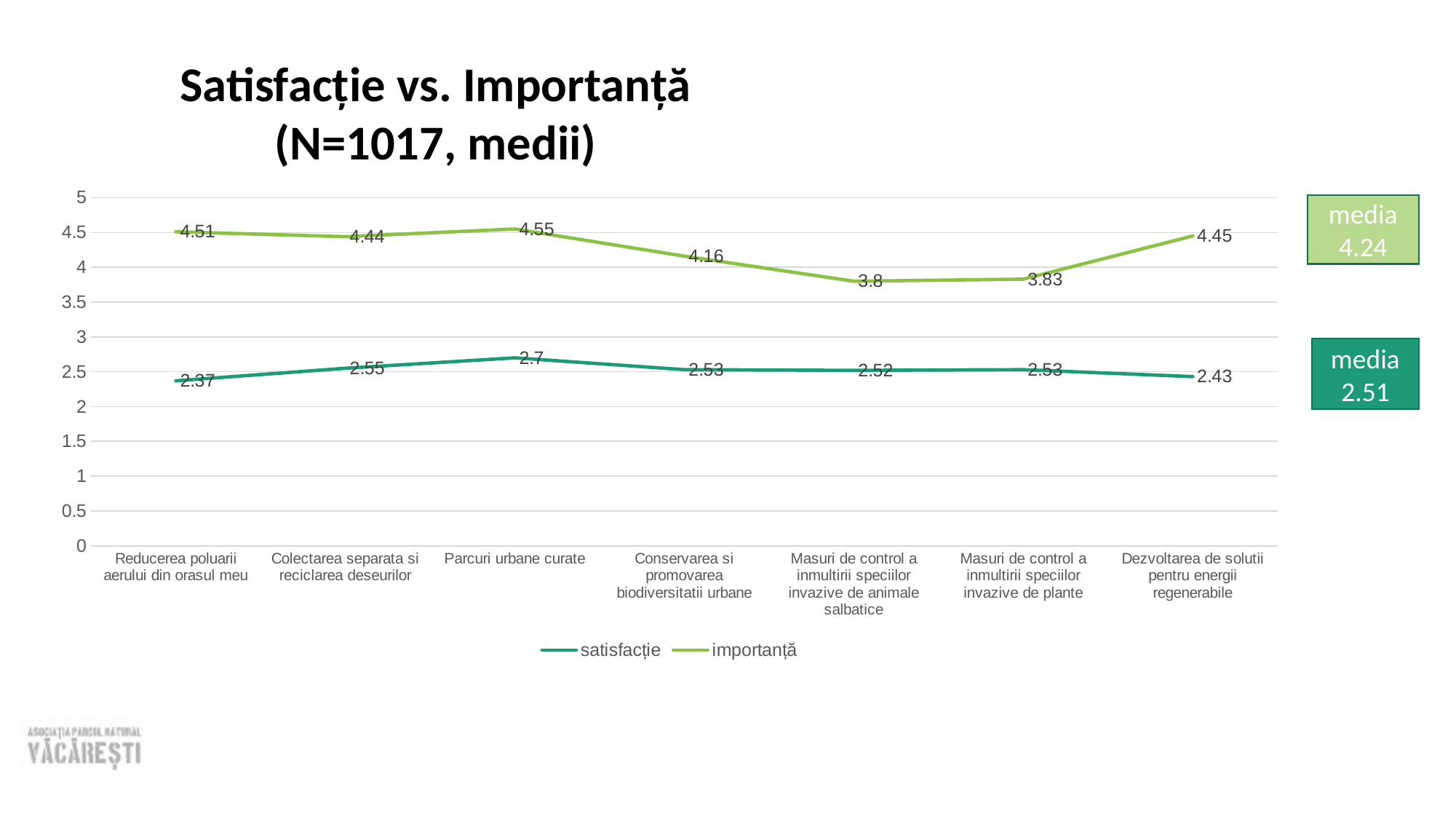
Which category has the highest satisfacție value? Parcuri urbane curate Is the importanță value for Conservarea si promovarea biodiversitatii urbane greater or less than 4? greater What is the satisfacție value for Reducerea poluarii aerului din orasul meu? 2.37 Which category has the lowest importanță value? Masuri de control a inmultirii speciilor invazive de animale salbatice What is the overall media (mean) shown for importanță in the box on the right? 4.24 What is the importanță value for Parcuri urbane curate? 4.55 What kind of chart is shown on the slide? line chart What is the importanță value for Masuri de control a inmultirii speciilor invazive de animale salbatice? 3.8 How many series does the legend list? 2 What is the difference between the importanță and satisfacție values for Dezvoltarea de solutii pentru energii regenerabile? 2.02 Which is larger, the satisfacție value for Colectarea separata si reciclarea deseurilor or for Dezvoltarea de solutii pentru energii regenerabile? Colectarea separata si reciclarea deseurilor How many categories are shown on the x axis? 7